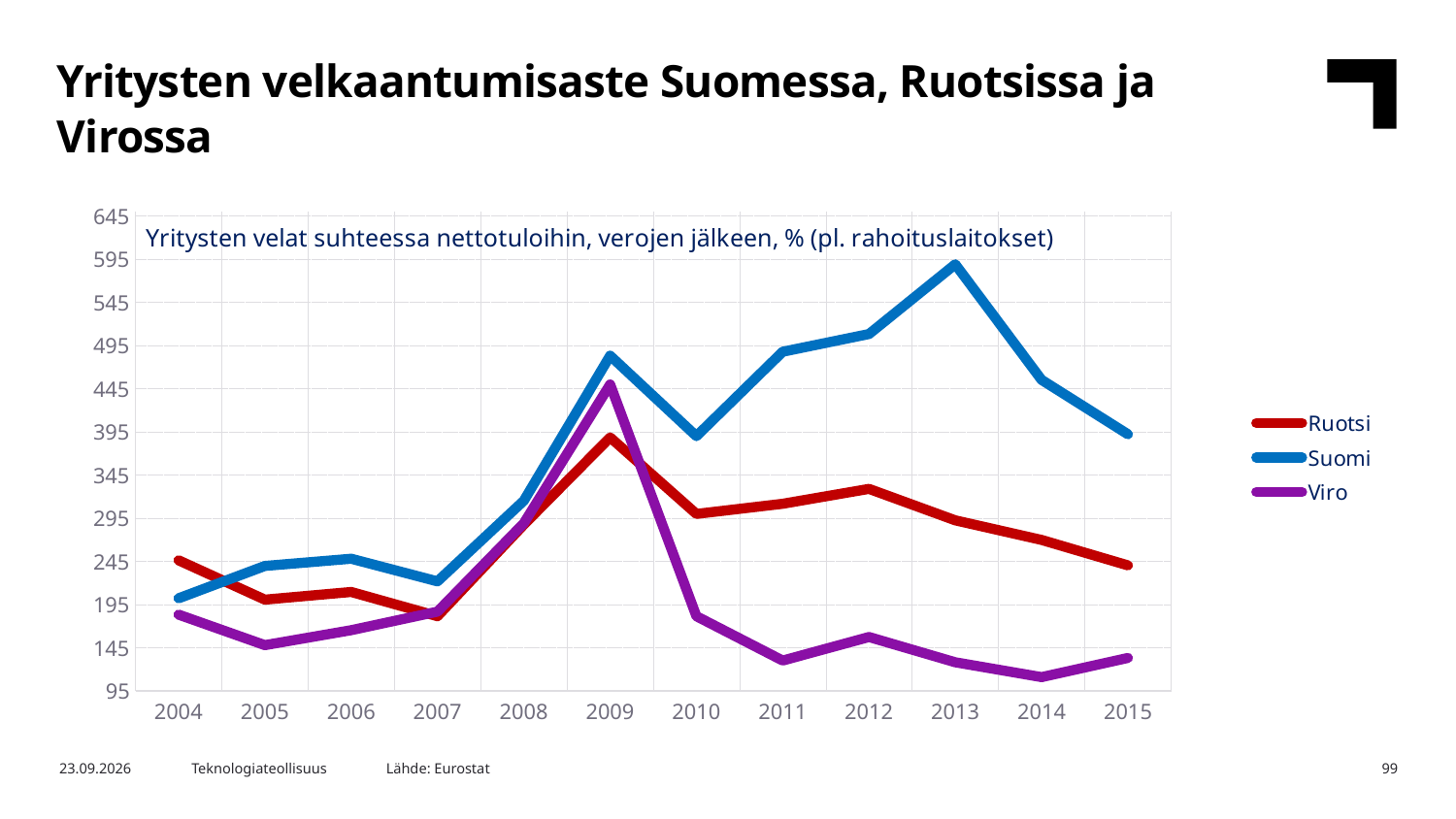
Is the value for Suomi in 2013 greater or less than 545? greater Is the value for Ruotsi in 2009 greater or less than 345? greater In which year does the Suomi line reach its peak? 2013 Does the Suomi line rise or fall from 2013 to 2015? fall What kind of chart is shown on the slide? line chart What is the subtitle printed inside the chart area? Yritysten velat suhteessa nettotuloihin, verojen jälkeen, % (pl. rahoituslaitokset) Which series has the highest value in 2013? Suomi In which year does the Viro line reach its peak? 2009 Is the value for Viro in 2014 greater or less than 145? less Which is larger in 2010, the value for Suomi or the value for Viro? Suomi How many series does the legend list? 3 How many years are plotted along the x axis? 12